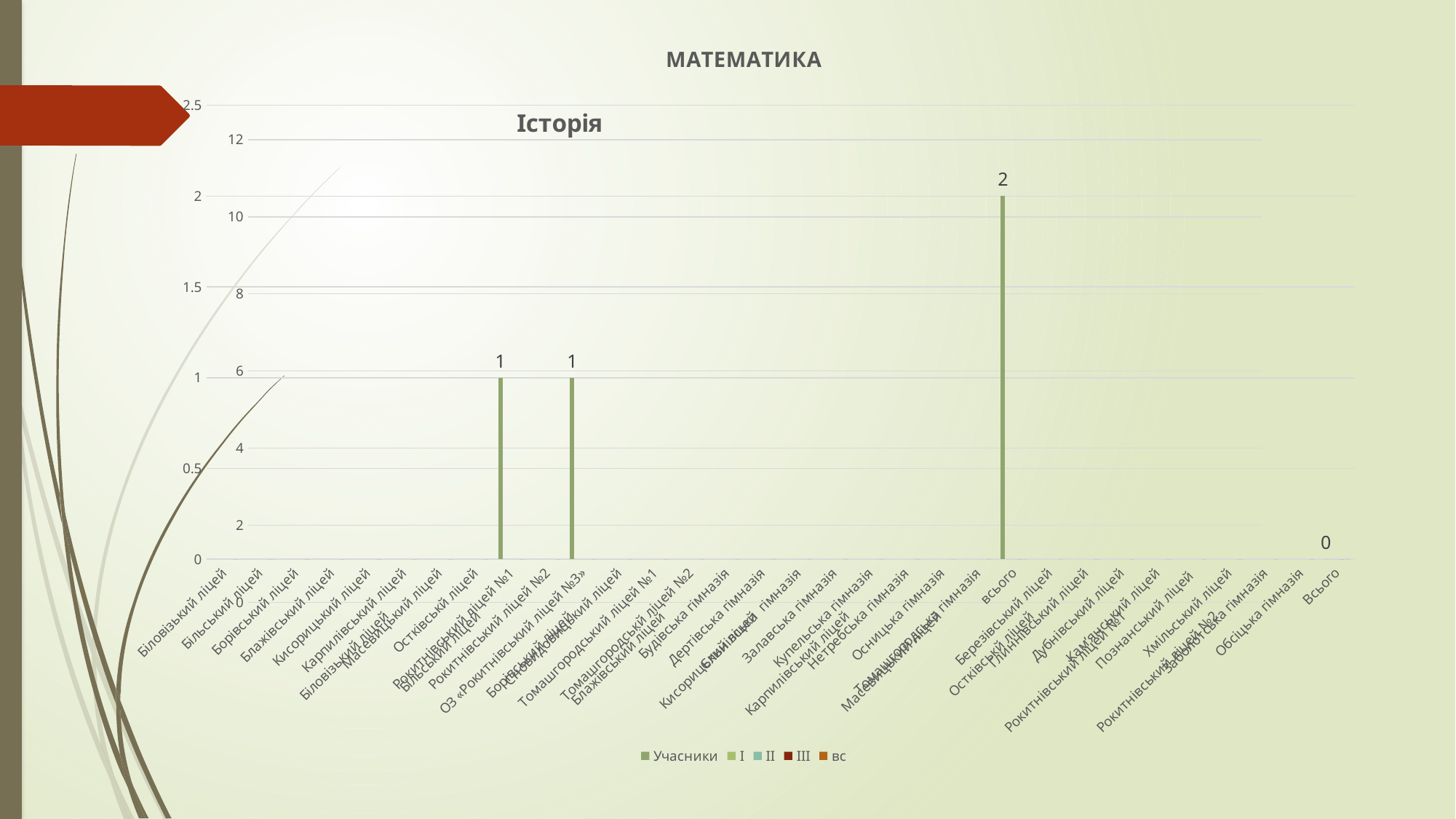
How many bars carry the data label 1? 2 What is the title of the chart in front, whose axis runs from 0 to 12? Історія What is the highest data label shown on any bar? 2 Is the bar labelled 2 larger or smaller than the bars labelled 1? larger What kind of chart is shown on the slide? bar chart What is the lowest data label printed on the chart? 0 What is the title of the chart behind, whose axis runs from 0 to 2.5? МАТЕМАТИКА How many series does the legend list? 5 What is the difference between the tallest bar (labelled 2) and a bar labelled 1? 1